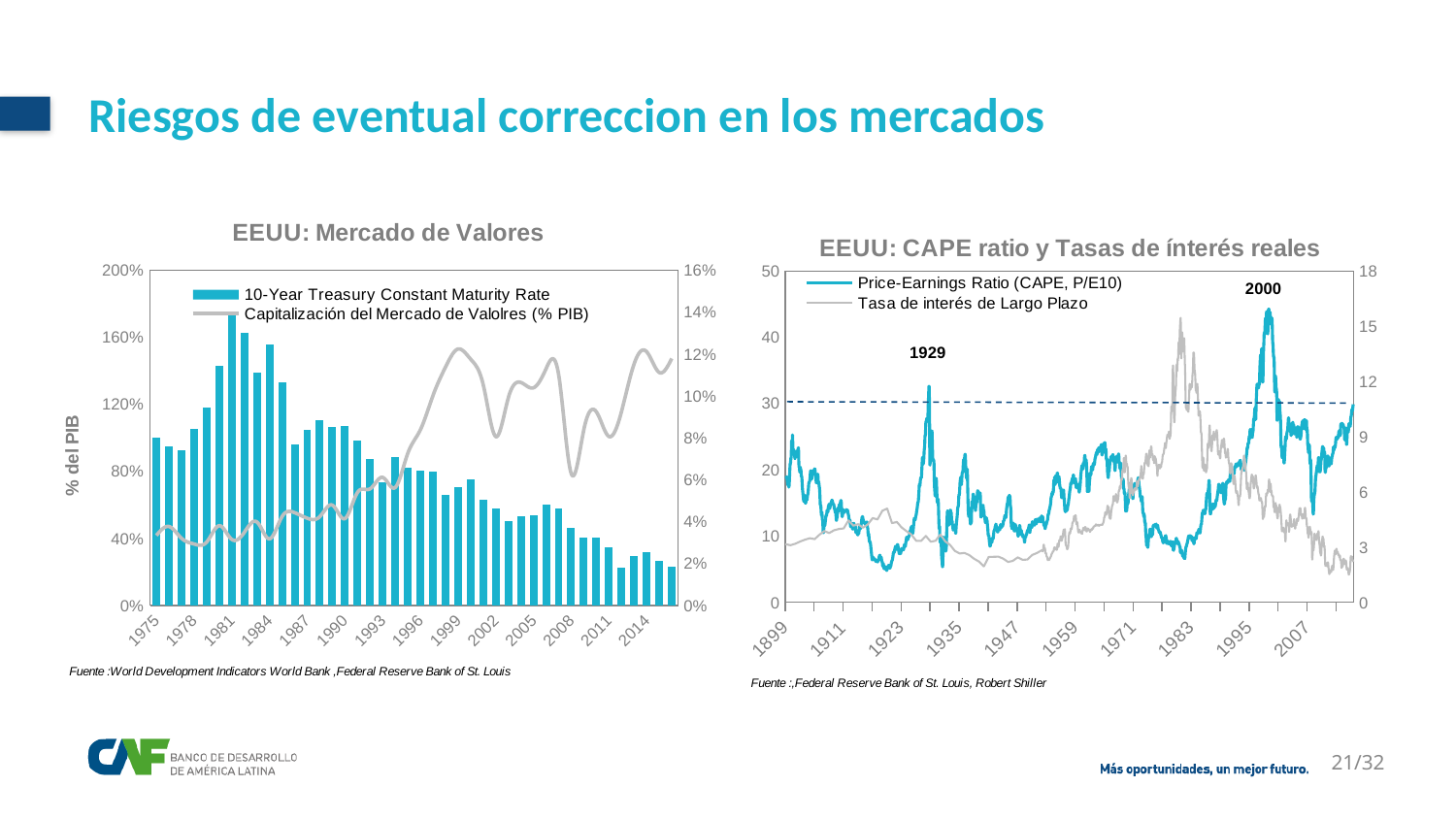
In the chart titled 'EEUU: Mercado de Valores', is the 10-Year Treasury Constant Maturity Rate for 2014 greater or less than 4%? less In the chart titled 'EEUU: CAPE ratio y Tasas de ínterés reales', is the Price-Earnings Ratio (CAPE, P/E10) at its 2000 peak greater or less than 40? greater In the chart titled 'EEUU: Mercado de Valores', do the 10-Year Treasury Constant Maturity Rate bars generally rise or fall from 1981 to 2014? fall In the chart titled 'EEUU: CAPE ratio y Tasas de ínterés reales', how many series does the legend list? 2 In the chart titled 'EEUU: Mercado de Valores', is the 10-Year Treasury Constant Maturity Rate for 1981 greater or less than 12%? greater In the chart titled 'EEUU: Mercado de Valores', which series is drawn as bars? 10-Year Treasury Constant Maturity Rate In the chart titled 'EEUU: CAPE ratio y Tasas de ínterés reales', which two years are labelled as peaks of the Price-Earnings Ratio (CAPE, P/E10)? 1929 and 2000 In the chart titled 'EEUU: Mercado de Valores', in which year is the 10-Year Treasury Constant Maturity Rate bar highest? 1981 In the chart titled 'EEUU: Mercado de Valores', how many series does the legend list? 2 What kind of chart is the chart titled 'EEUU: CAPE ratio y Tasas de ínterés reales'? line chart In the chart titled 'EEUU: Mercado de Valores', which is larger: the 10-Year Treasury Constant Maturity Rate in 1981 or in 2011? 1981